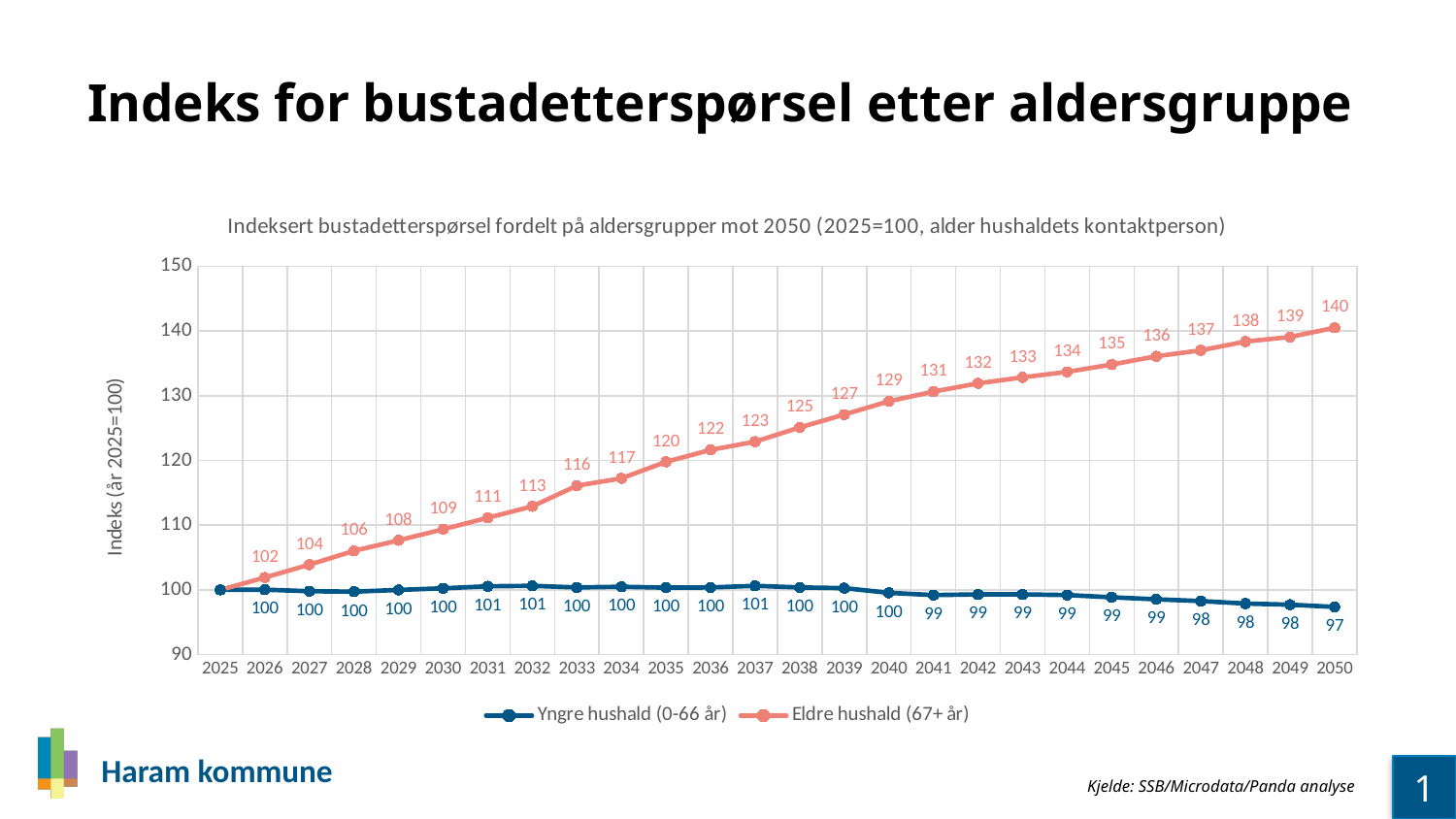
Does the value for Eldre hushald (67+ år) rise or fall from 2025 to 2050? Rise What is the value for Eldre hushald (67+ år) in 2040? 129 What kind of chart is shown on the slide? Line chart In which year does Yngre hushald (0-66 år) have its lowest value? 2050 Which series has the higher value in 2035, Eldre hushald (67+ år) or Yngre hushald (0-66 år)? Eldre hushald (67+ år) How many series does the legend list? 2 What is the difference between Eldre hushald (67+ år) and Yngre hushald (0-66 år) in 2050? 43 What is the value for Eldre hushald (67+ år) in 2050? 140 Is the value for Eldre hushald (67+ år) in 2045 greater or less than 130? greater What is the value for Eldre hushald (67+ år) in 2033? 116 What is the value for Yngre hushald (0-66 år) in 2050? 97 In which year does Eldre hushald (67+ år) reach its highest value? 2050